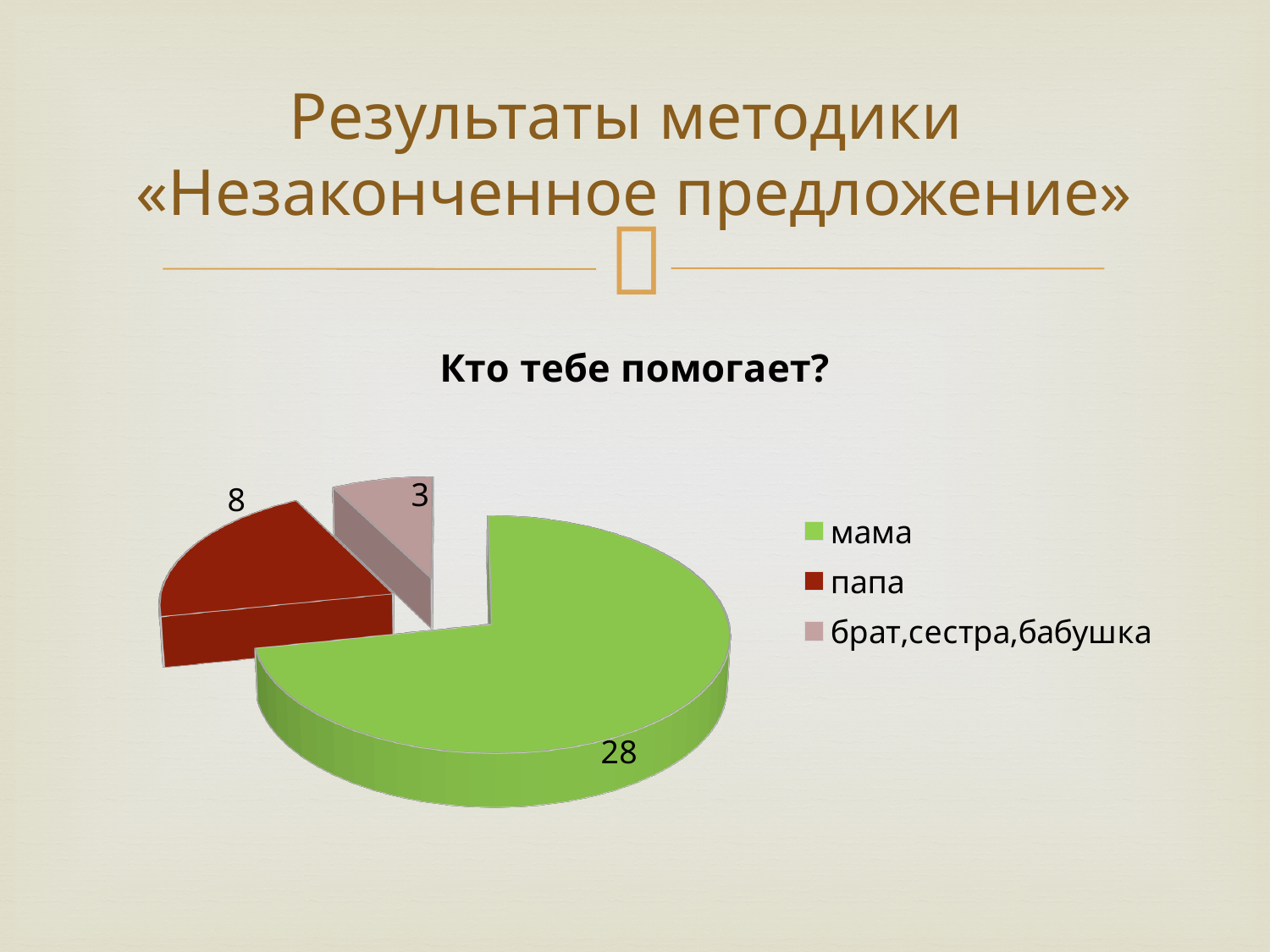
What is the value for брат,сестра,бабушка? 3 What is the value for мама? 28 Which is larger, the value for папа or the value for брат,сестра,бабушка? папа What is the value for папа? 8 What is the difference between the values for мама and папа? 20 What is the title of the chart? Кто тебе помогает? Which category has the smallest slice? брат,сестра,бабушка What is the difference between the values for папа and брат,сестра,бабушка? 5 What kind of chart is shown on the slide? pie chart Which category has the largest slice? мама How many categories does the pie chart have? 3 What is the total of all slices in the pie chart? 39